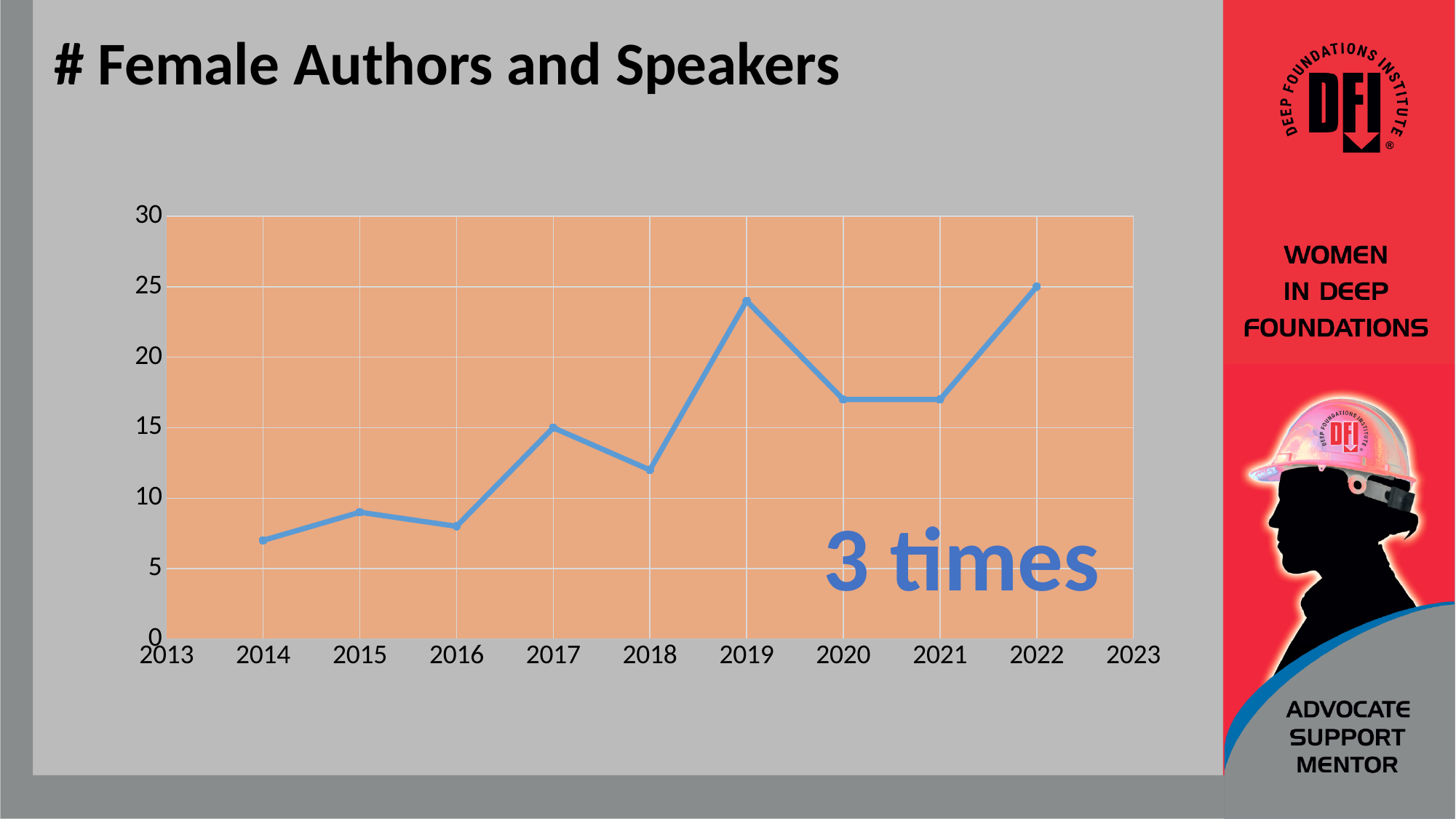
What text annotation is printed inside the plot area? 3 times Is the value for 2014 greater or less than 10? less Is the value for 2019 greater or less than 20? greater What is the value for 2022? 25 What kind of chart is shown on the slide? line chart What is the value for 2017? 15 Is the value for 2018 greater or less than 15? less Which is larger, the value for 2018 or the value for 2019? 2019 How many data points are plotted on the line? 9 What is the title of the chart? # Female Authors and Speakers Overall, do the values rise or fall from 2014 to 2022? rise